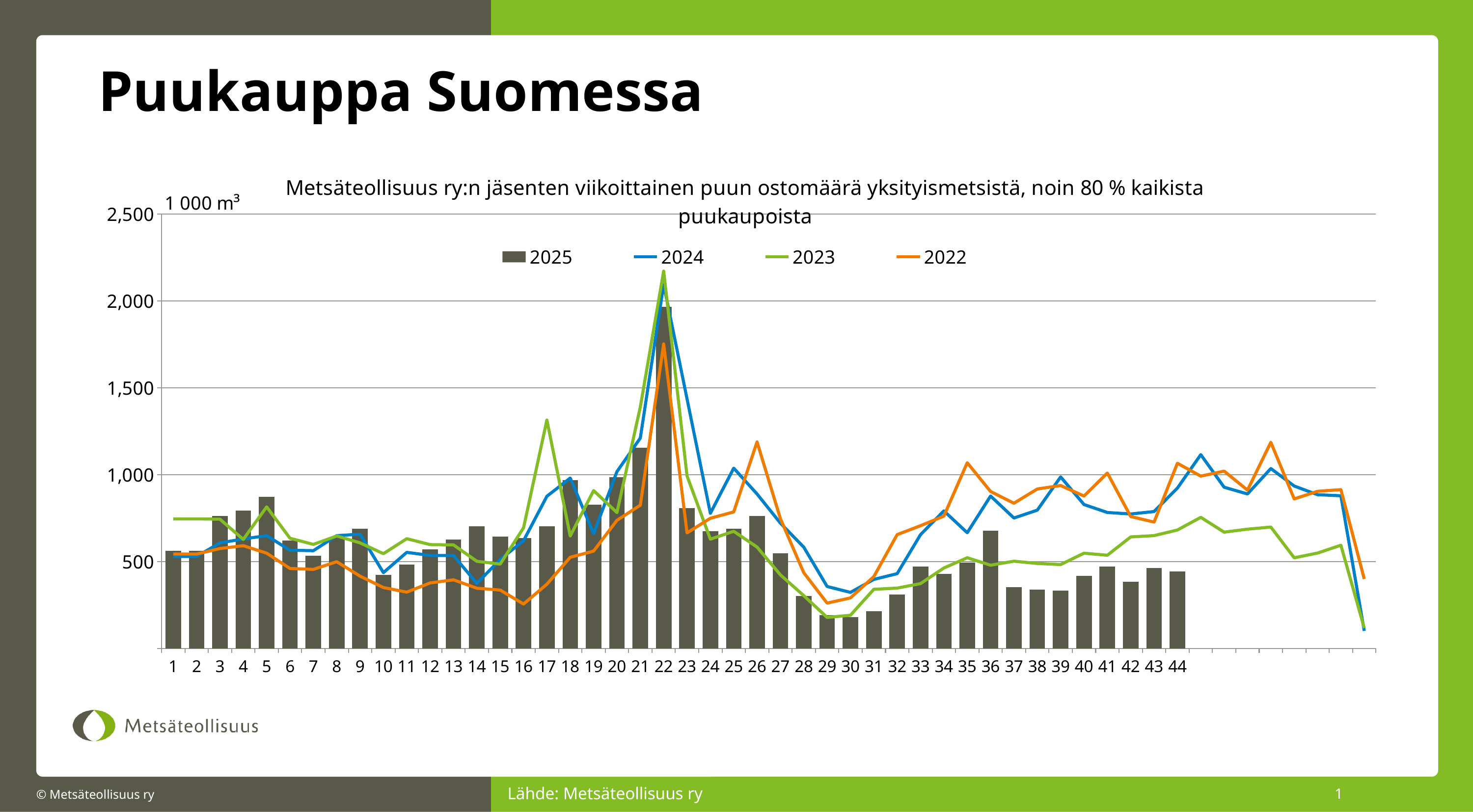
Which week has the highest 2025 bar? 22 What kind of chart is this? A combined bar and line chart Is the 2025 value for week 21 greater or less than 1,000? greater Which is larger, the 2025 value for week 22 or for week 21? Week 22 Do the 2025 bars rise or fall from week 22 to week 29? fall Is the 2025 value for week 5 greater or less than 500? greater Is the 2025 value for week 22 greater or less than 1,500? greater How many weeks are labelled on the x axis? 44 How many series does the legend list? 4 What unit is shown at the top of the vertical axis? 1 000 m³ At week 17, which series is higher, 2023 or 2022? 2023